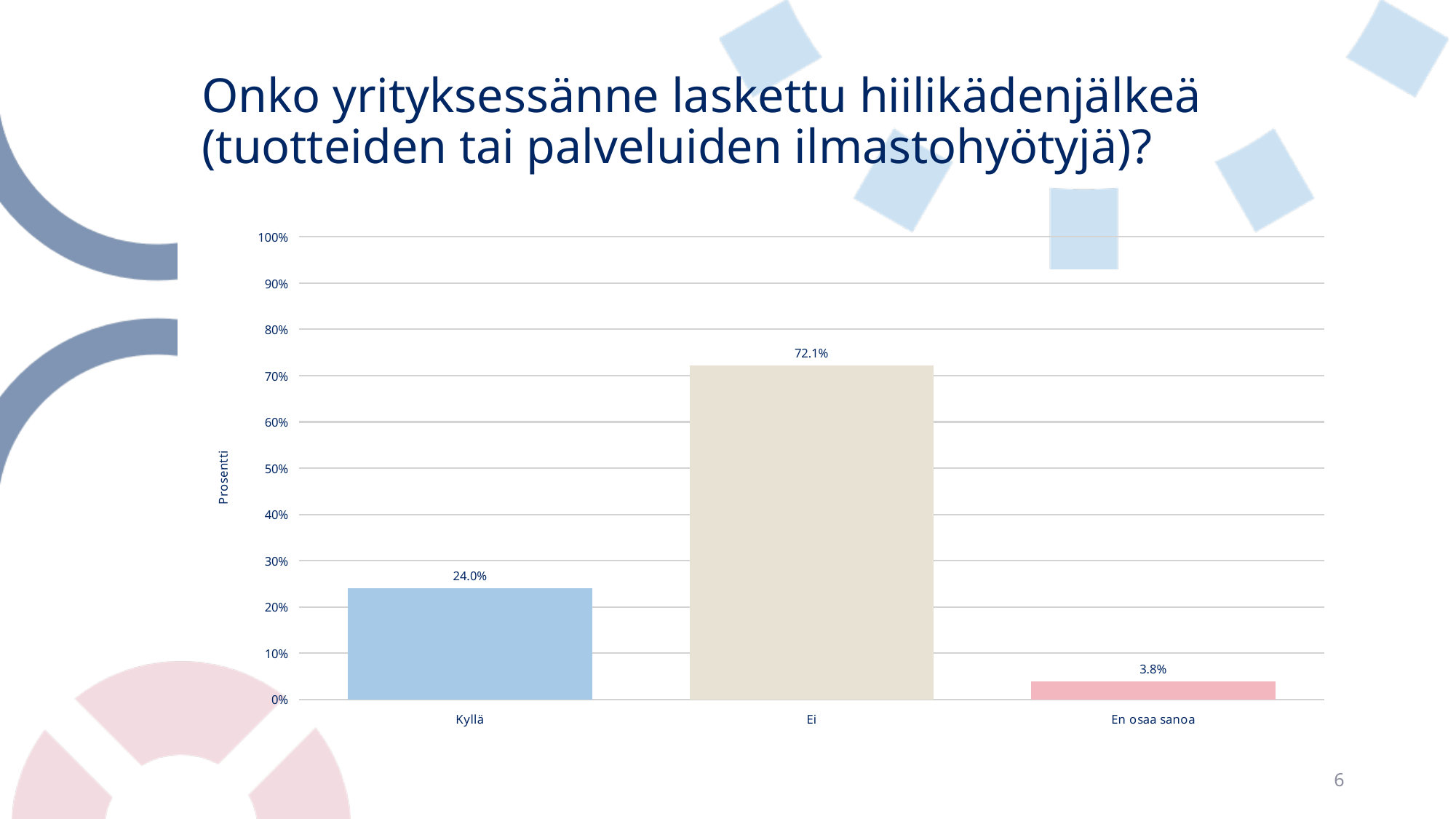
What is the value for Kyllä? 24.0% What is the difference between the values for Kyllä and En osaa sanoa? 20.2% Which is larger, the value for Kyllä or the value for Ei? Ei Is the value for Ei greater or less than 70%? greater Which category has the highest value? Ei Which category has the lowest value? En osaa sanoa What is the label of the vertical axis? Prosentti What kind of chart is shown on the slide? bar chart What is the value for Ei? 72.1% What is the difference between the values for Ei and Kyllä? 48.1% How many categories are shown on the x axis? 3 What is the value for En osaa sanoa? 3.8%